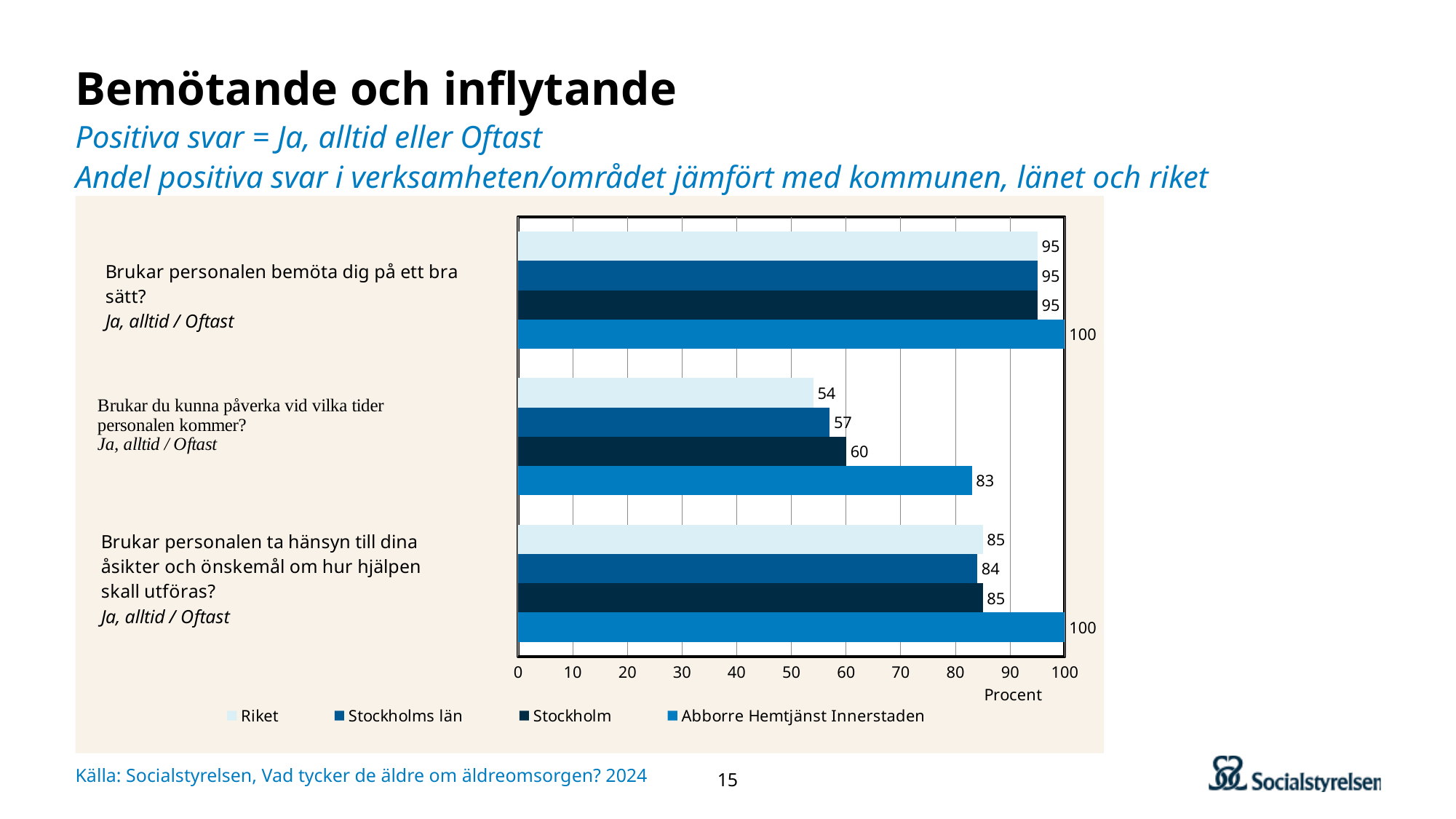
Which series has the highest value for "Brukar du kunna påverka vid vilka tider personalen kommer?"? Abborre Hemtjänst Innerstaden How many series does the legend list? 4 What is the value for Stockholm for "Brukar personalen bemöta dig på ett bra sätt?"? 95 What kind of chart is shown on the slide? Bar chart For "Brukar personalen ta hänsyn till dina åsikter och önskemål om hur hjälpen skall utföras?", which is larger: Abborre Hemtjänst Innerstaden or Riket? Abborre Hemtjänst Innerstaden What is the value for Stockholms län for "Brukar personalen ta hänsyn till dina åsikter och önskemål om hur hjälpen skall utföras?"? 84 Which series has the lowest value for "Brukar du kunna påverka vid vilka tider personalen kommer?"? Riket What is the label of the x axis? Procent What is the value for Riket for "Brukar du kunna påverka vid vilka tider personalen kommer?"? 54 What is the value for Abborre Hemtjänst Innerstaden for "Brukar du kunna påverka vid vilka tider personalen kommer?"? 83 How many questions (categories) are shown on the chart? 3 What is the difference between Abborre Hemtjänst Innerstaden and Stockholm for "Brukar du kunna påverka vid vilka tider personalen kommer?"? 23